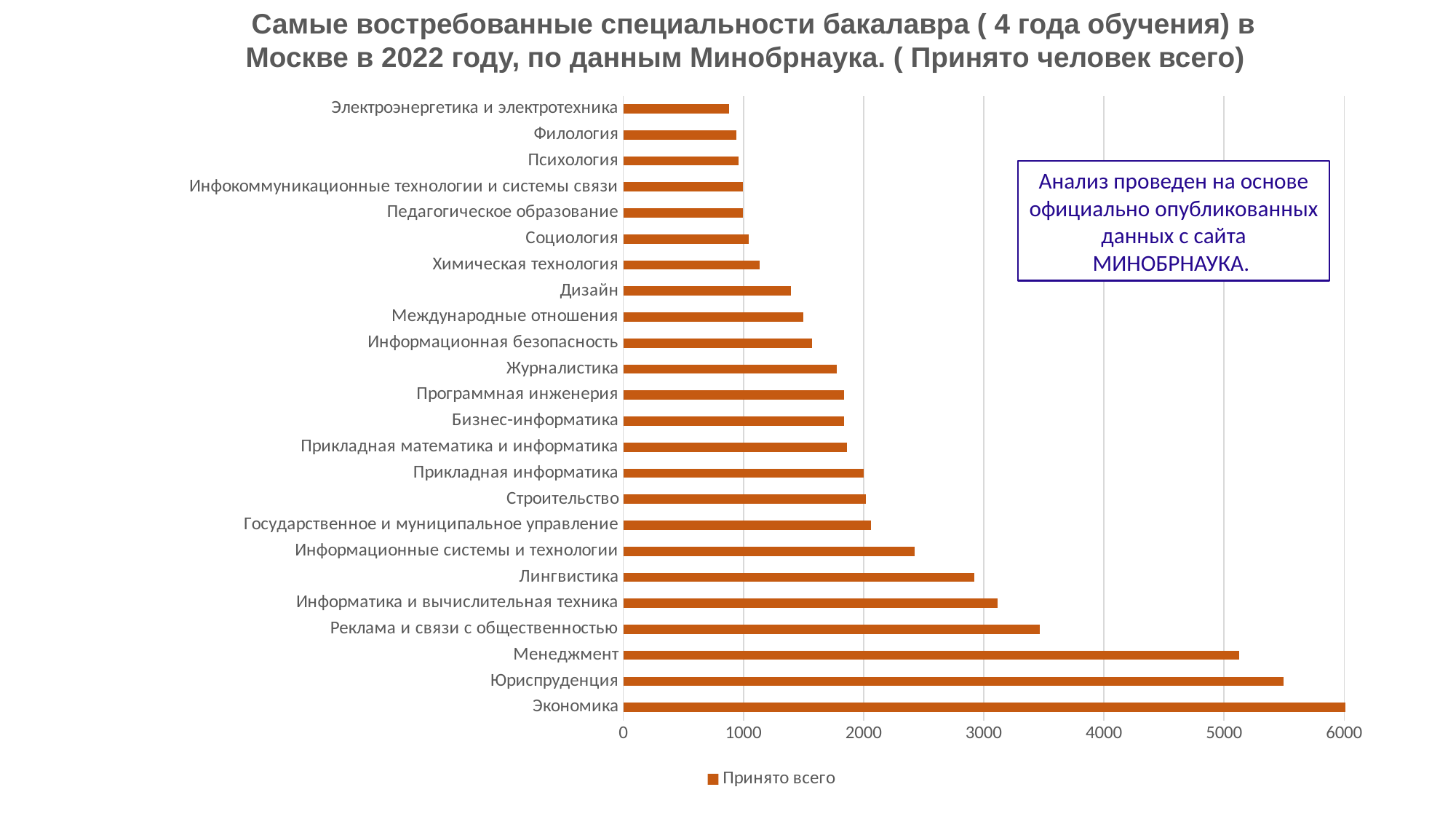
What is the name of the series shown in the legend? Принято всего Which has a larger value: Юриспруденция or Менеджмент? Юриспруденция Which has a larger value: Лингвистика or Дизайн? Лингвистика Is the value for Менеджмент greater or less than 5000? greater What kind of chart is shown on the slide? Bar chart Is the value for Журналистика greater or less than 2000? less Is the value for Реклама и связи с общественностью greater or less than 3000? greater Which specialty has the highest number of admitted students? Экономика How many series does the legend list? 1 How many specialties (categories) are plotted in the chart? 24 Which specialty has the lowest number of admitted students? Электроэнергетика и электротехника